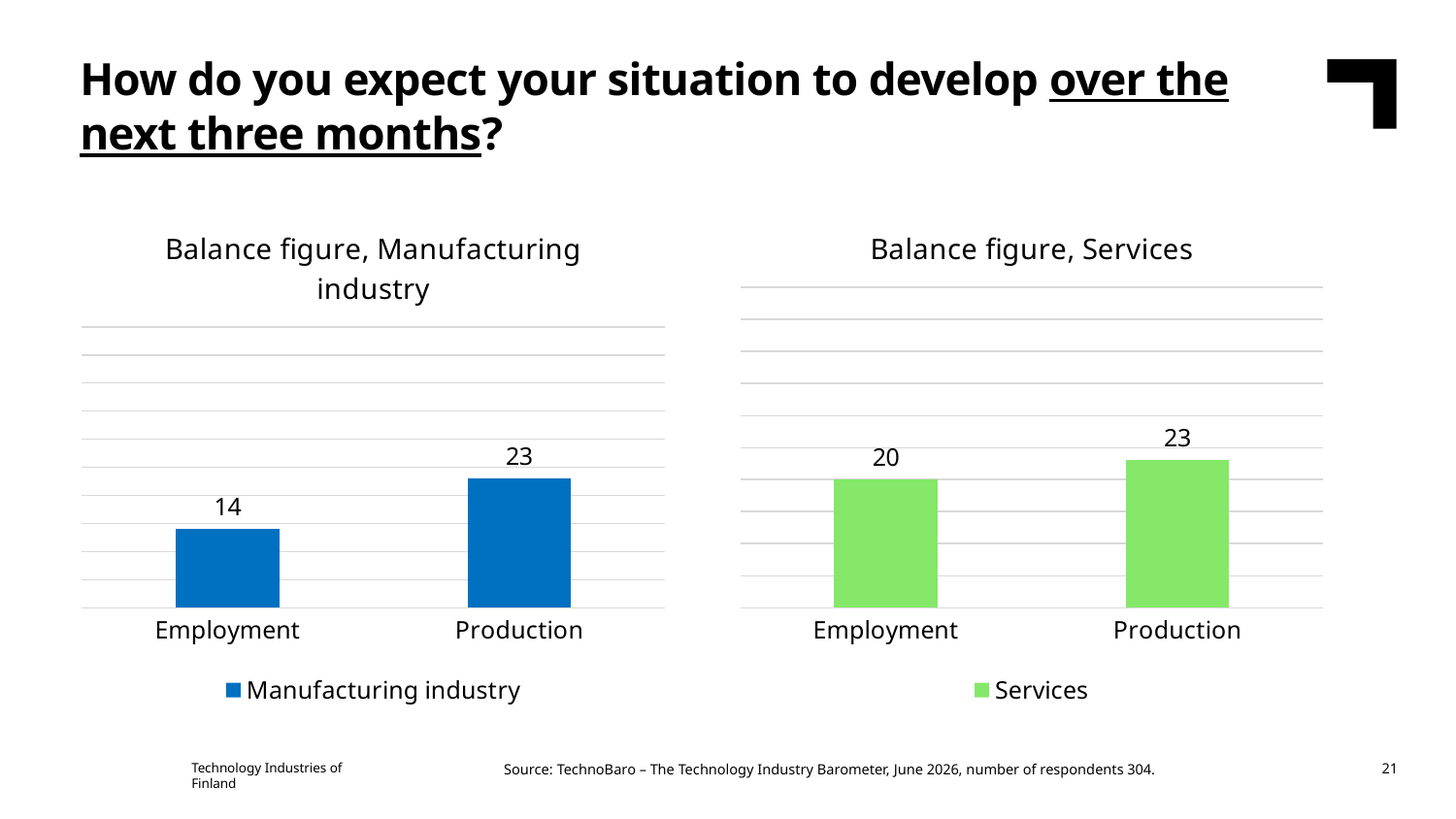
What series does the legend of the 'Balance figure, Services' chart list? Services In the 'Balance figure, Manufacturing industry' chart, which category has the highest value? Production In the 'Balance figure, Manufacturing industry' chart, what is the value for Employment? 14 In the 'Balance figure, Services' chart, what is the value for Production? 23 How many categories are shown in the 'Balance figure, Services' chart? 2 In the 'Balance figure, Manufacturing industry' chart, what is the value for Production? 23 In the 'Balance figure, Services' chart, what is the value for Employment? 20 In the 'Balance figure, Manufacturing industry' chart, what is the difference between the Production and Employment values? 9 In the 'Balance figure, Services' chart, what is the difference between the Production and Employment values? 3 What kind of chart is the 'Balance figure, Manufacturing industry' chart? Bar chart Which is larger: the Employment value in the 'Balance figure, Manufacturing industry' chart or the Employment value in the 'Balance figure, Services' chart? Services In the 'Balance figure, Services' chart, which category has the lowest value? Employment